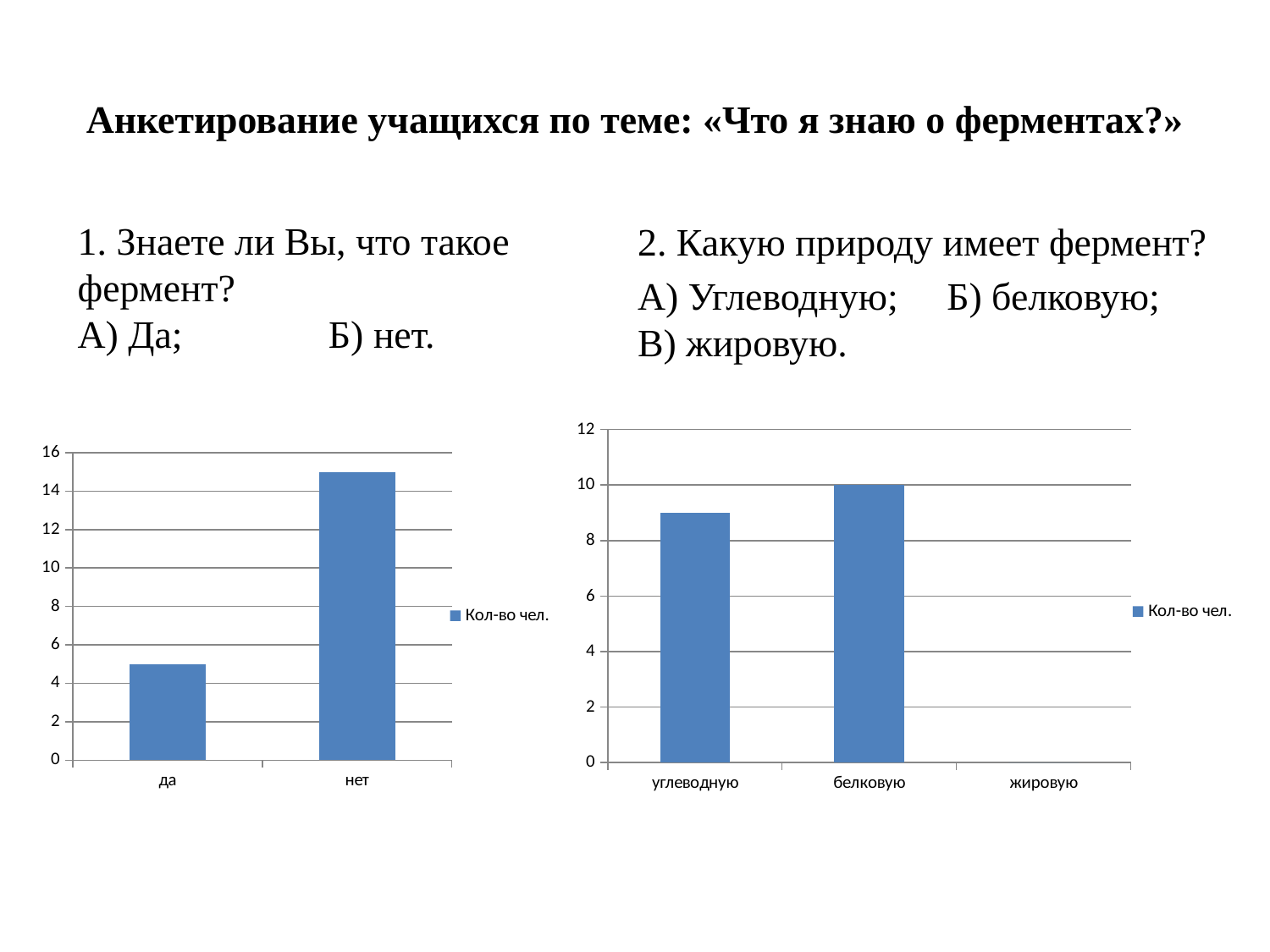
How many categories are shown in the left chart (question 1)? 2 In the left chart (question 1), is the value for нет greater or less than 14? greater In the left chart (question 1), which category has the higher value? нет In the right chart (question 2), is the value for углеводную greater or less than 8? greater What kind of chart is the left chart (question 1)? bar chart In the right chart (question 2), which category has the lowest value? жировую In the right chart (question 2), what is the value for белковую? 10 In the right chart (question 2), what is the value for жировую? 0 In the right chart (question 2), which category has the highest value? белковую In the left chart (question 1), is the value for да greater or less than 6? less What series name does the legend of the right chart (question 2) show? Кол-во чел. How many categories are shown in the right chart (question 2)? 3